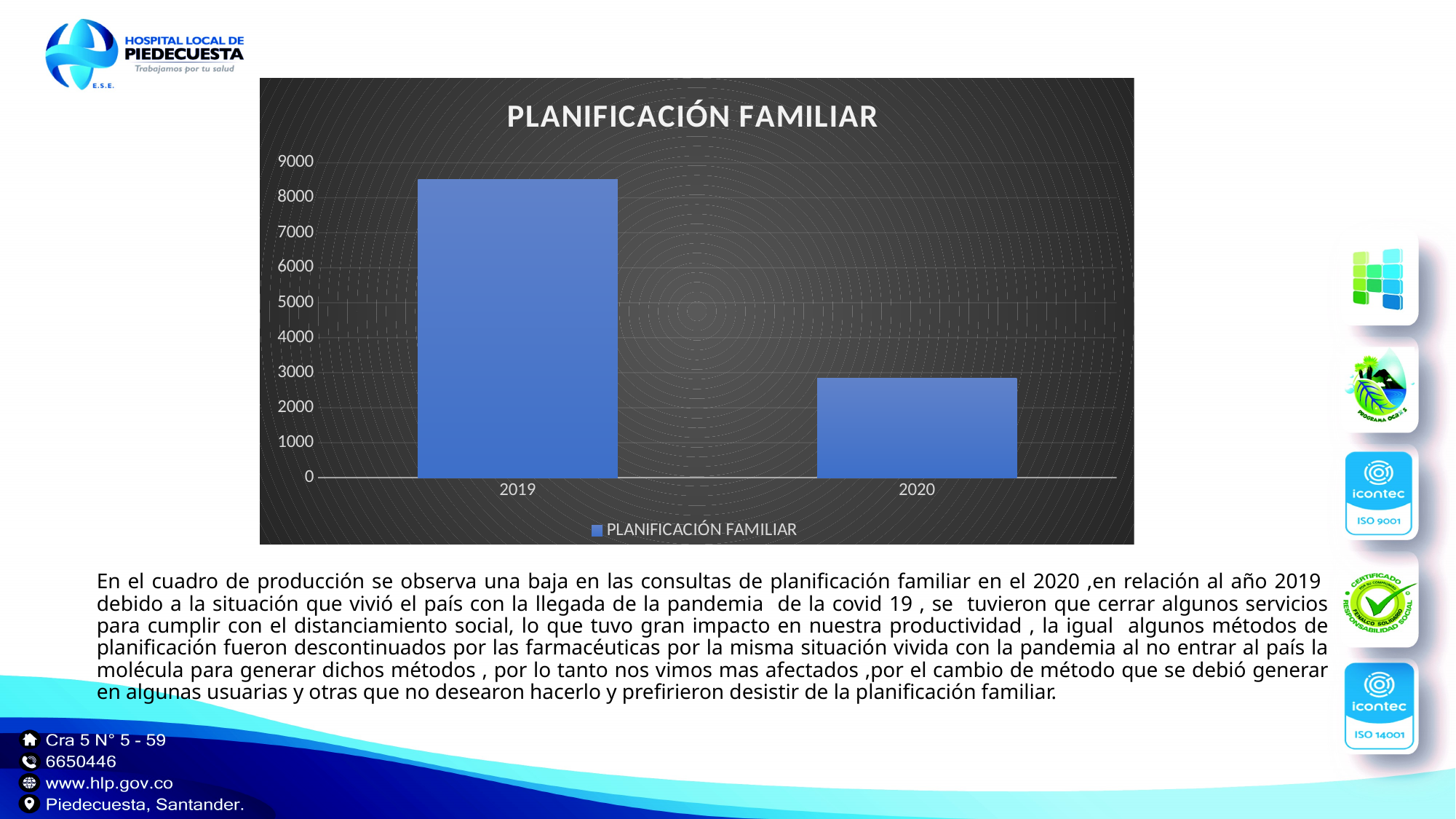
Is the value for 2020 greater or less than 4000? less How many series does the chart legend list? 1 Is the value for 2020 greater or less than 2000? greater How many categories are shown on the x axis of the chart? 2 Do the values rise or fall from 2019 to 2020? fall What kind of chart is shown on the slide? bar chart Which year has the lowest value in the chart? 2020 Is the value for 2019 greater or less than 8000? greater What is the title of the chart? PLANIFICACIÓN FAMILIAR Which year has the highest value in the chart? 2019 Which is larger, the value for 2019 or the value for 2020? 2019